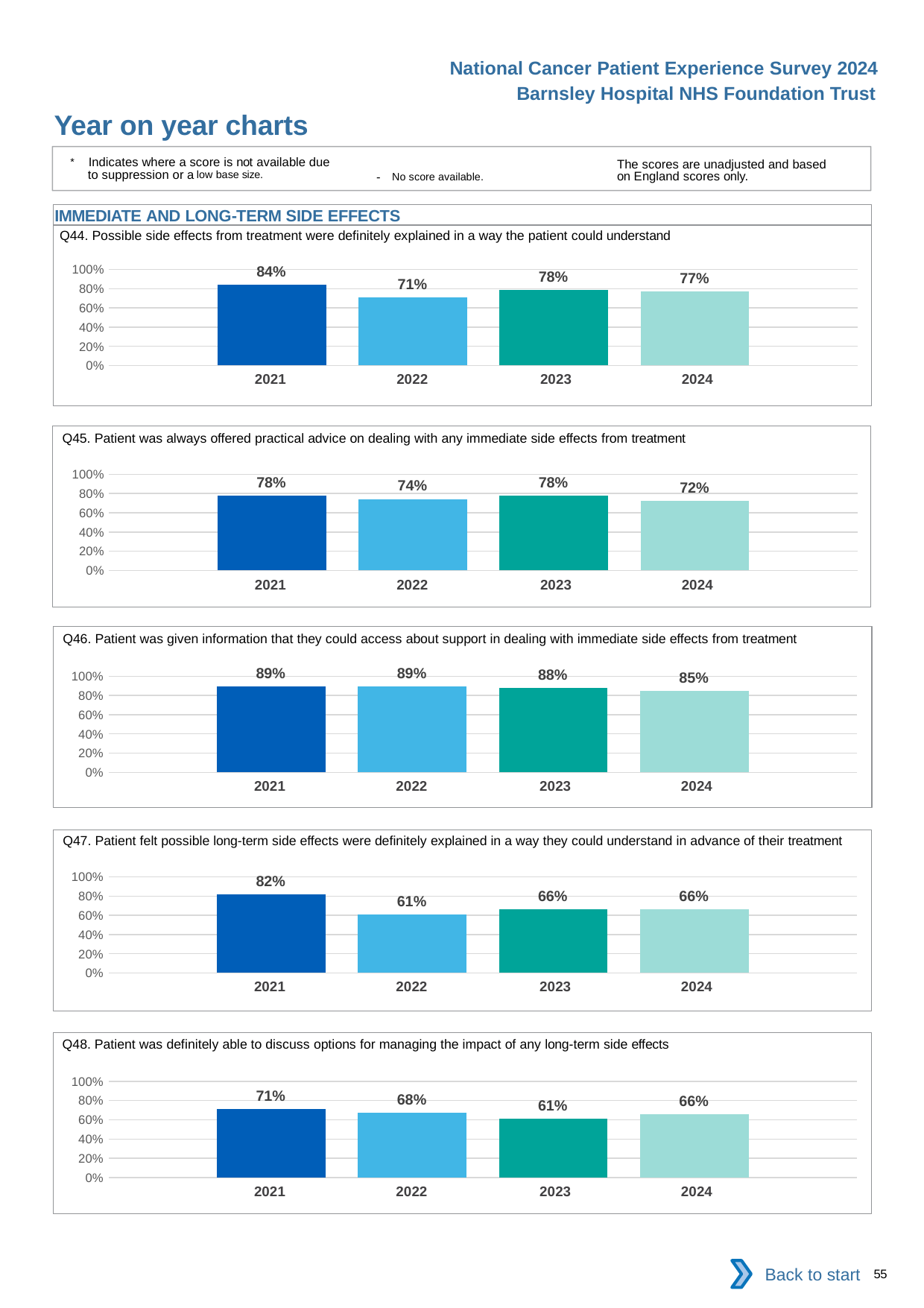
How many years are shown on the x axis of the Q48 chart? 4 In the Q48 chart, is the value for 2022 larger or smaller than the value for 2023? larger What type of chart is the Q44 chart? bar chart In the Q47 chart, which year has the highest value? 2021 In the Q46 chart, which year has the lowest value? 2024 In the Q47 chart, what is the difference between the 2021 and 2022 values? 21 percentage points In the Q45 chart, what is the value for 2022? 74% In the Q44 chart, which year has the lowest value? 2022 In the Q44 chart, what is the value for 2021? 84% In the Q46 chart, what is the value for 2023? 88% In the Q45 chart, what is the difference between the 2023 and 2024 values? 6 percentage points In the Q48 chart, what is the value for 2024? 66%